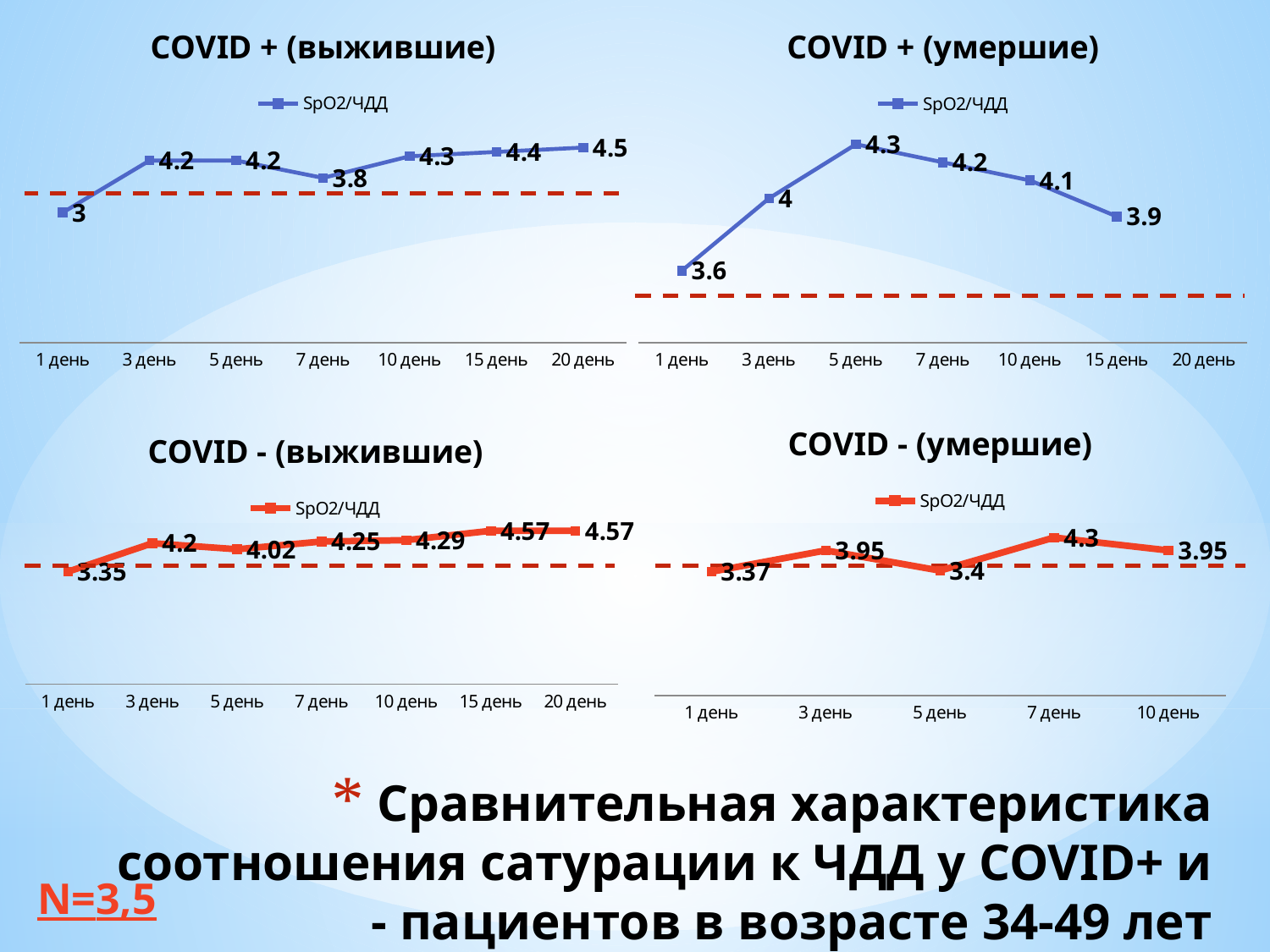
In the "COVID + (умершие)" chart, what is the value on 1 день? 3.6 What type of chart is "COVID + (выжившие)"? Line chart In the "COVID + (выжившие)" chart, what is the value on 20 день? 4.5 In the "COVID - (выжившие)" chart, what is the value on 15 день? 4.57 In the "COVID + (выжившие)" chart, what is the SpO2/ЧДД value on 1 день? 3 In the "COVID + (умершие)" chart, which day has the highest value? 5 день In the "COVID + (умершие)" chart, what is the difference between the value on 5 день and the value on 15 день? 0.4 In the "COVID - (умершие)" chart, which is larger: the value on 3 день or the value on 5 день? 3 день In the "COVID - (умершие)" chart, what is the value on 7 день? 4.3 In the "COVID - (умершие)" chart, how many data points are plotted? 5 In the "COVID - (выжившие)" chart, which day has the lowest value? 1 день What series name is shown in the legend of the "COVID - (выжившие)" chart? SpO2/ЧДД